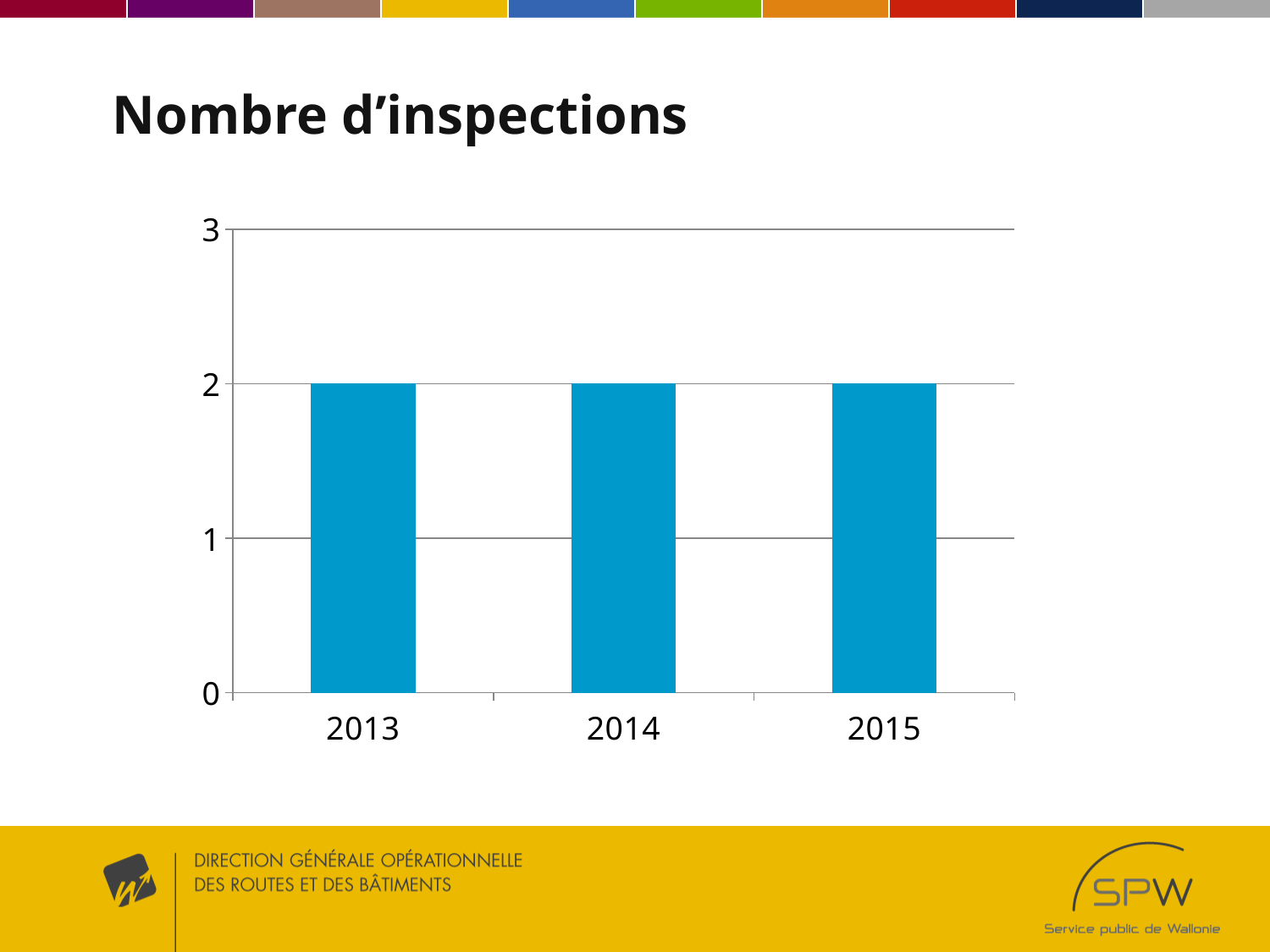
What is the value for 2015? 2 What is the title shown above the chart? Nombre d'inspections What kind of chart is shown on the slide? bar chart What is the value for 2014? 2 What is the highest value shown on the y axis? 3 What is the difference between the values for 2013 and 2015? 0 Do the values rise, fall or stay the same from 2013 to 2015? stay the same What is the value for 2013? 2 Is the value for 2015 greater or less than 3? less How many categories are shown on the x axis? 3 Is the value for 2014 greater or less than 1? greater What colour are the bars in the chart? blue